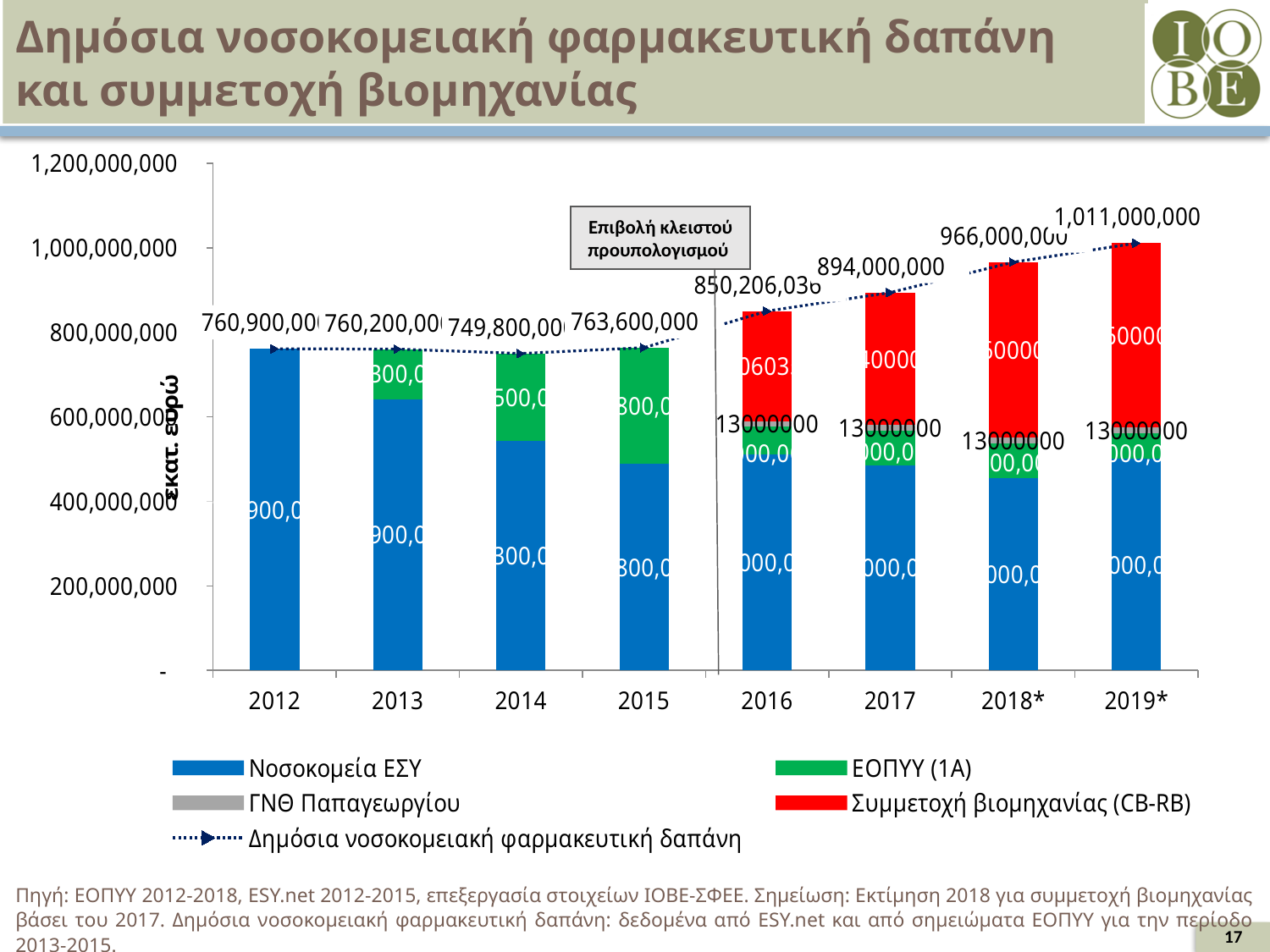
How many series does the chart legend list? 5 Does the Δημόσια νοσοκομειακή φαρμακευτική δαπάνη rise or fall from 2016 to 2019*? rise Is the Δημόσια νοσοκομειακή φαρμακευτική δαπάνη for 2012 greater or less than 800,000,000? less Which year has the highest Δημόσια νοσοκομειακή φαρμακευτική δαπάνη? 2019* What text appears in the annotation box above the 2015 bar? Επιβολή κλειστού προυπολογισμού What is the value of Δημόσια νοσοκομειακή φαρμακευτική δαπάνη for 2017? 894,000,000 How many years are shown on the x axis of the chart? 8 Which year has the lowest Δημόσια νοσοκομειακή φαρμακευτική δαπάνη? 2014 What is the value of Δημόσια νοσοκομειακή φαρμακευτική δαπάνη for 2015? 763,600,000 What is the value of Δημόσια νοσοκομειακή φαρμακευτική δαπάνη for 2019*? 1,011,000,000 What kind of chart is shown on the slide? combination bar and line chart What is the difference between the Δημόσια νοσοκομειακή φαρμακευτική δαπάνη for 2019* and for 2017? 117,000,000